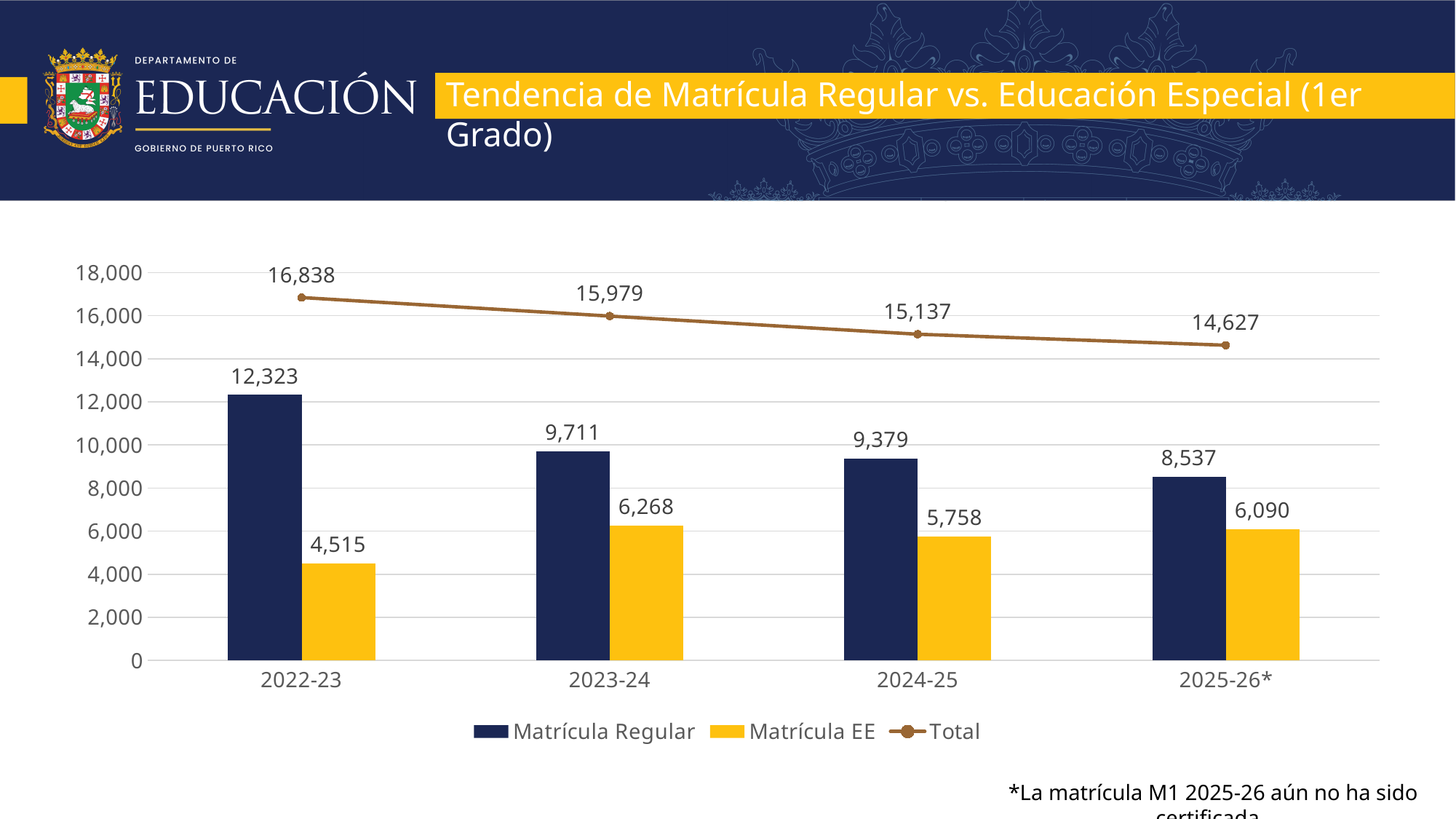
What colour are the Matrícula EE bars? yellow Which year has the lowest Matrícula EE value? 2022-23 Which is larger, the Matrícula EE value for 2023-24 or for 2025-26*? 2023-24 What is the Matrícula EE value for 2024-25? 5,758 Does the Total line rise or fall from 2022-23 to 2025-26*? fall What is the Matrícula Regular value for 2022-23? 12,323 Which year has the highest Matrícula Regular value? 2022-23 What is the difference between the Matrícula Regular and Matrícula EE values in 2023-24? 3,443 How many school years are shown on the x axis? 4 How many series does the legend list? 3 What is the Total value for 2025-26*? 14,627 Is the Matrícula Regular value for 2025-26* greater or less than 10,000? less